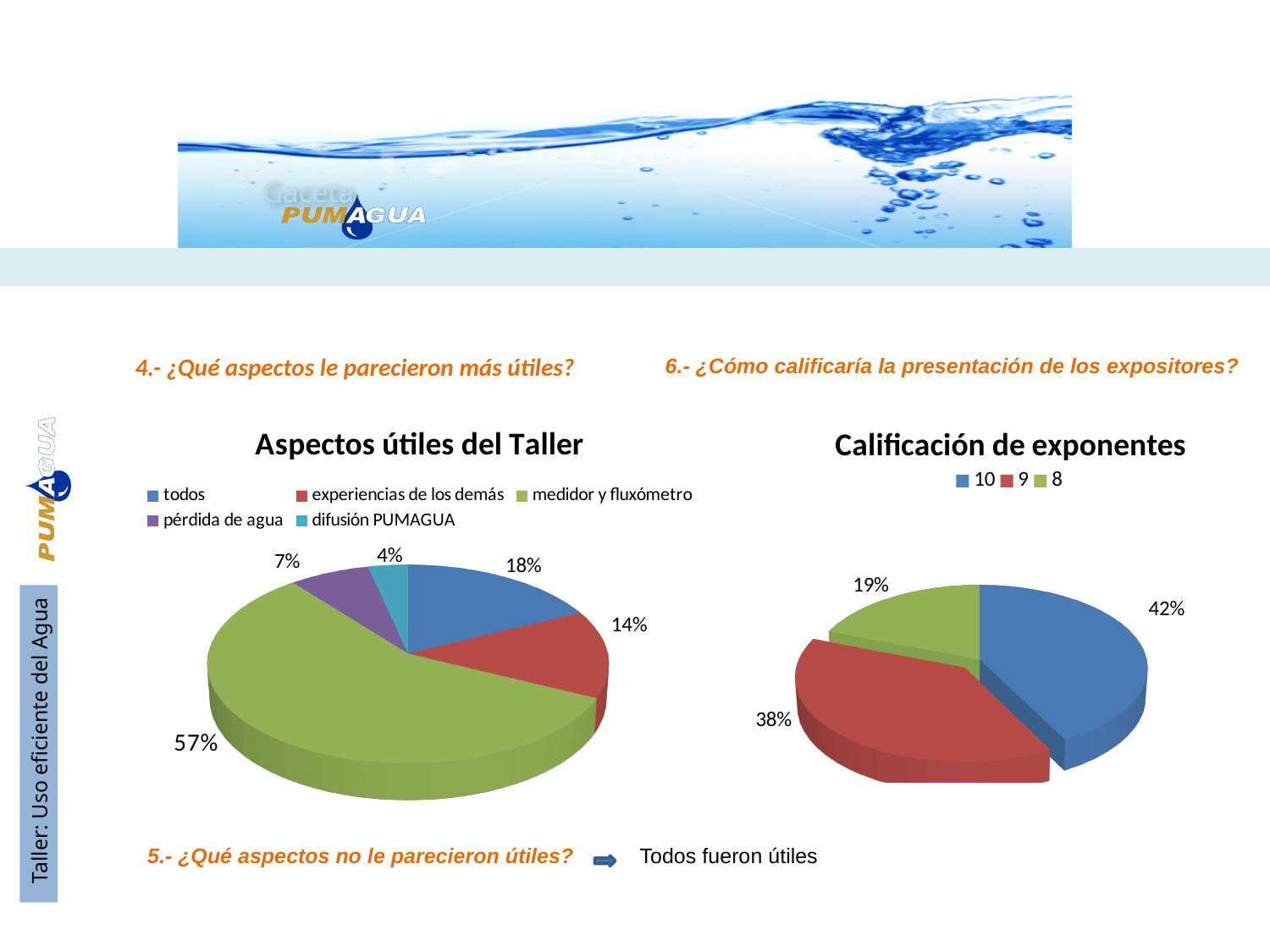
In the 'Aspectos útiles del Taller' chart, what share does 'medidor y fluxómetro' have? 57% In the 'Aspectos útiles del Taller' chart, how many categories does the legend list? 5 In the 'Aspectos útiles del Taller' chart, which category has the largest slice? medidor y fluxómetro In the 'Calificación de exponentes' chart, what is the difference between the shares of ratings '9' and '8'? 19% In the 'Calificación de exponentes' chart, what share does the rating '8' have? 19% What kind of chart is 'Calificación de exponentes'? Pie chart In the 'Aspectos útiles del Taller' chart, which category has the smallest slice? difusión PUMAGUA In the 'Aspectos útiles del Taller' chart, what share does 'todos' have? 18% In the 'Aspectos útiles del Taller' chart, what is the difference between the shares of 'todos' and 'experiencias de los demás'? 4% In the 'Calificación de exponentes' chart, which rating has the smallest slice? 8